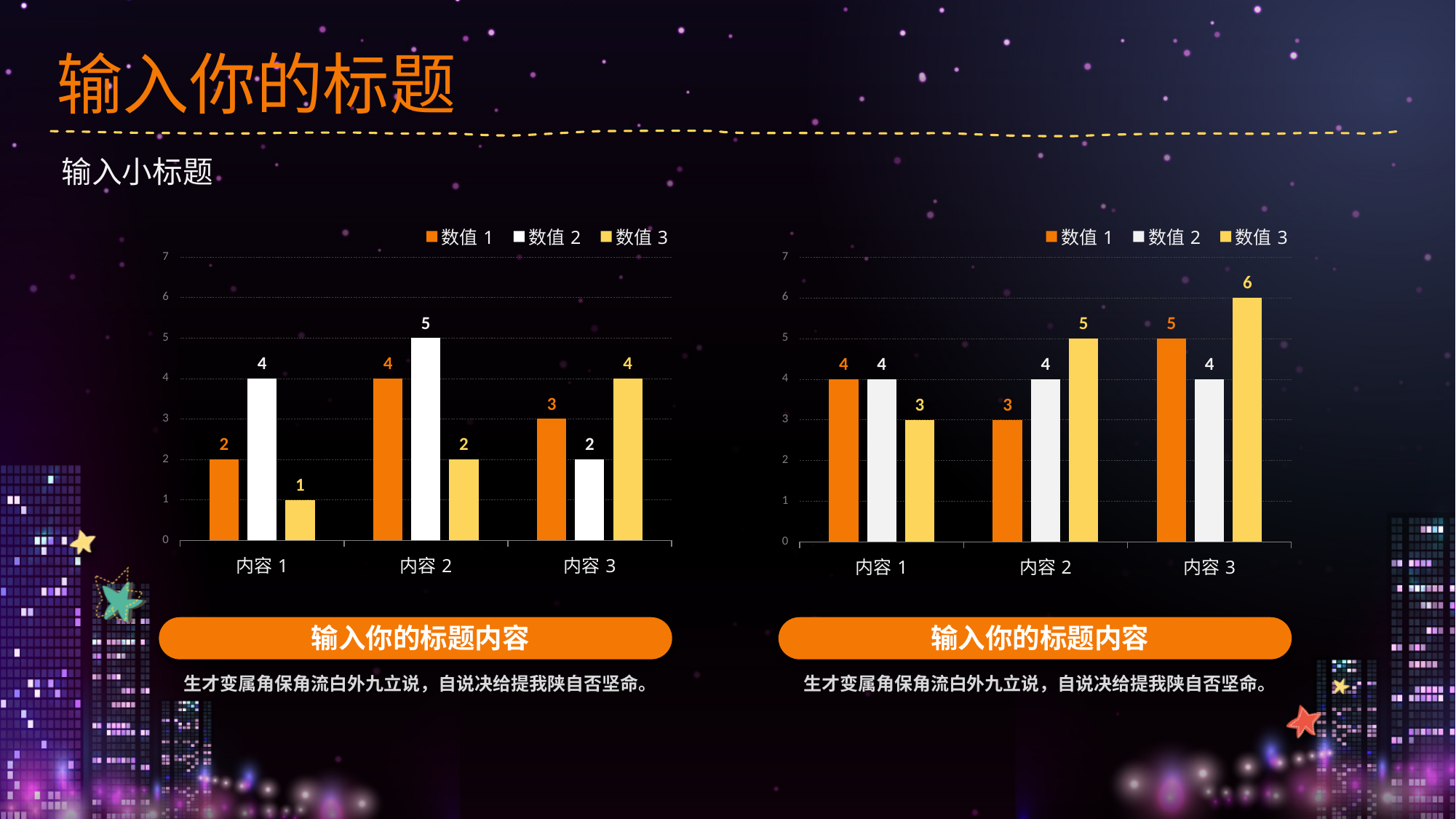
What kind of chart is the left chart? bar chart In the left chart, what is the difference between 数值 2 and 数值 3 for 内容 2? 3 In the right chart, what is the value of 数值 1 for 内容 2? 3 How many categories are shown on the x axis of the left chart? 3 In the right chart, do the values of 数值 3 rise or fall from 内容 1 to 内容 3? rise In the right chart, which category has the lowest value for 数值 3? 内容 1 In the left chart, which category has the highest value for 数值 1? 内容 2 In the right chart, what is the value of 数值 3 for 内容 3? 6 In the left chart, what is the value of 数值 3 for 内容 1? 1 In the left chart, what is the value of 数值 2 for 内容 2? 5 How many series does the legend of the right chart list? 3 In the right chart, which is larger for 内容 3: 数值 1 or 数值 3? 数值 3